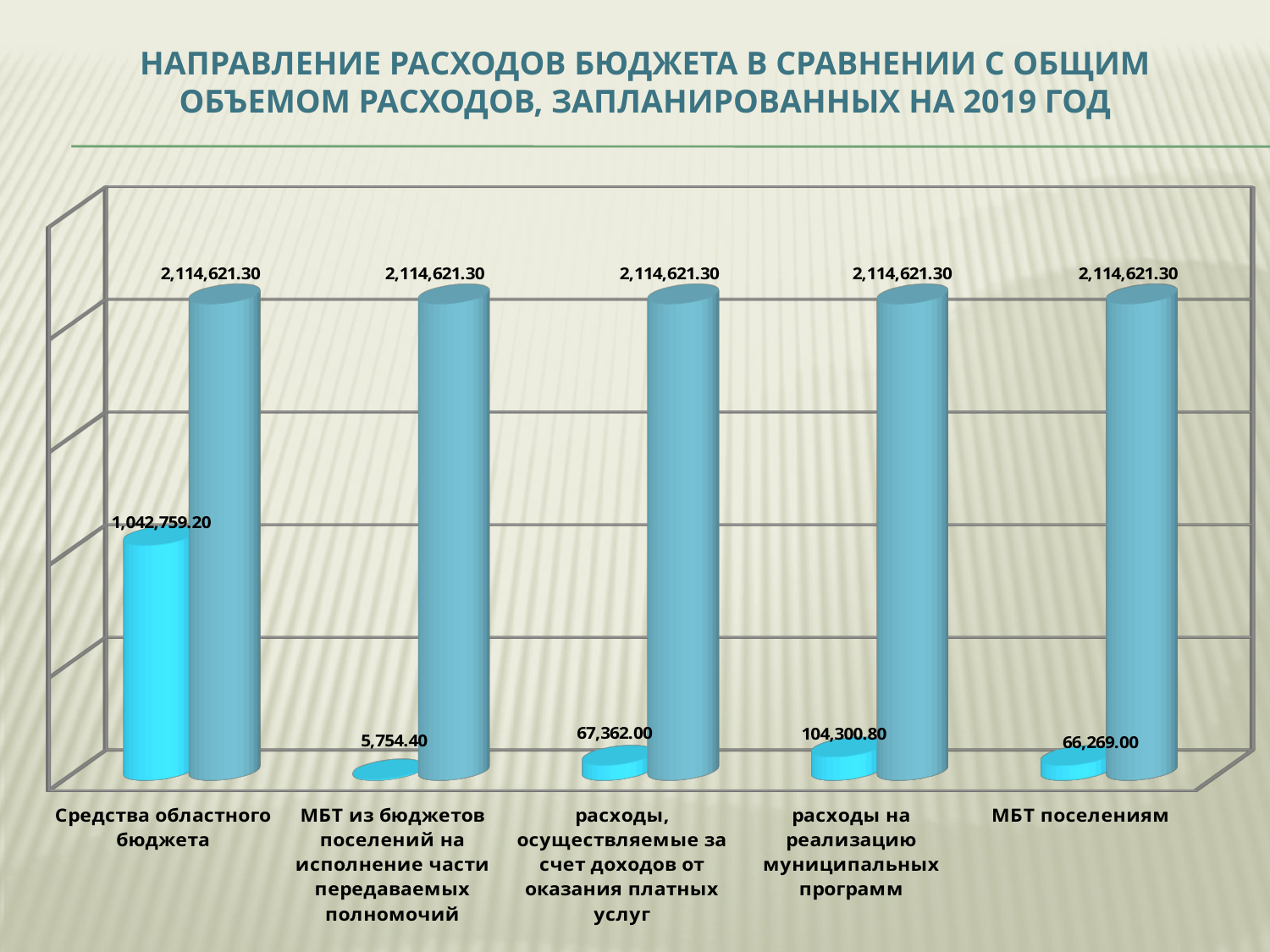
How many categories are shown on the x axis? 5 What is the value of the smaller (first) bar for "Средства областного бюджета"? 1,042,759.20 What is the value of the smaller bar for "МБТ из бюджетов поселений на исполнение части передаваемых полномочий"? 5,754.40 What value is shown on the taller bar in every category? 2,114,621.30 Among the smaller (first) bars, which category has the highest value? Средства областного бюджета What kind of chart is shown on the slide? Bar chart What is the value of the smaller bar for "МБТ поселениям"? 66,269.00 What is the difference between the two bars for "Средства областного бюджета"? 1,071,862.10 Among the smaller (first) bars, which category has the lowest value? МБТ из бюджетов поселений на исполнение части передаваемых полномочий Which is larger: the smaller bar for "расходы, осуществляемые за счет доходов от оказания платных услуг" or the smaller bar for "МБТ поселениям"? расходы, осуществляемые за счет доходов от оказания платных услуг What is the value of the smaller bar for "расходы на реализацию муниципальных программ"? 104,300.80 What is the difference between the smaller bars for "расходы на реализацию муниципальных программ" and "расходы, осуществляемые за счет доходов от оказания платных услуг"? 36,938.80